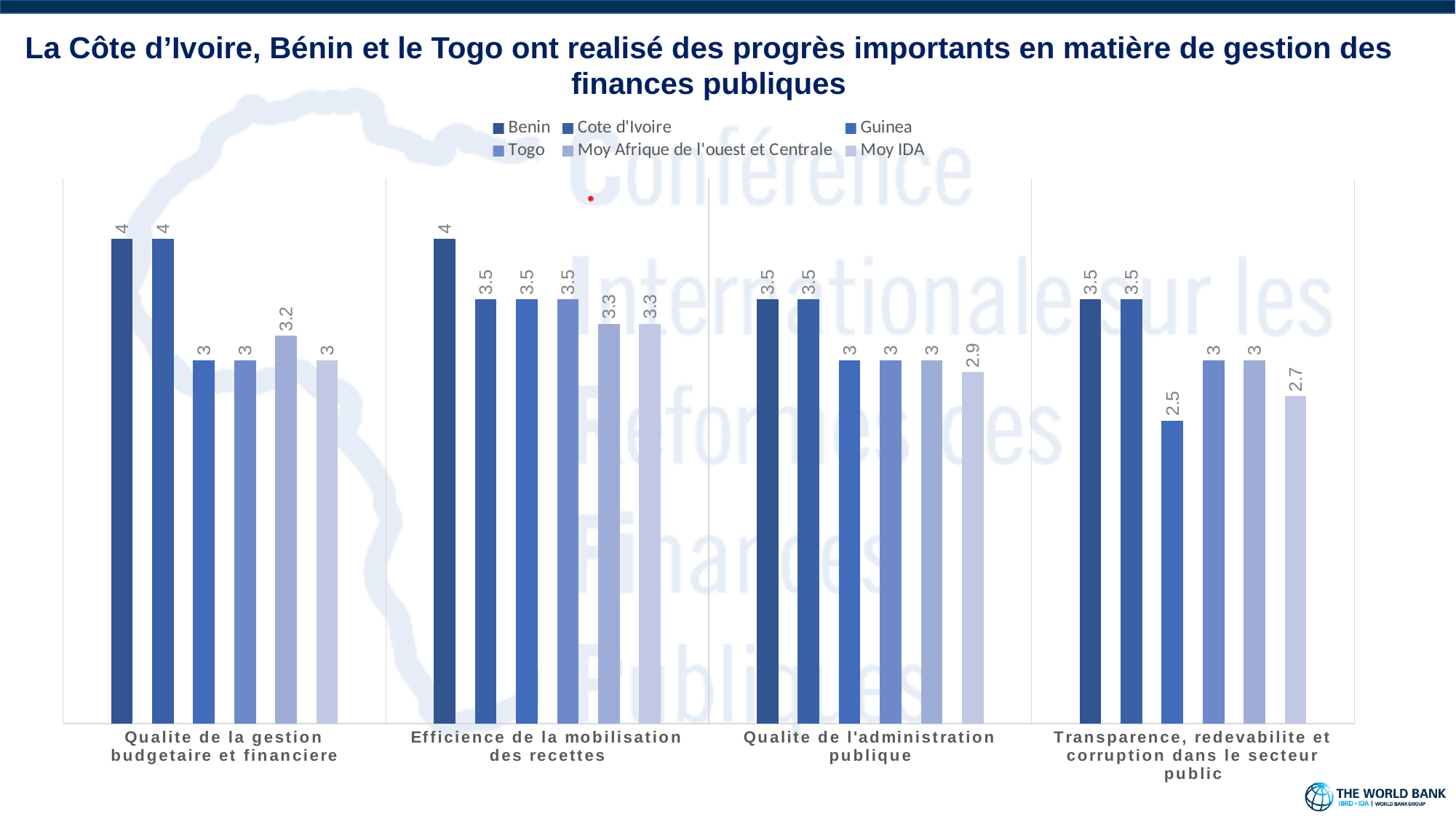
How many categories are shown on the x axis? 4 Which series has the lowest value in the category 'Qualite de l'administration publique'? Moy IDA What is the difference between Benin and Guinea in the category 'Transparence, redevabilite et corruption dans le secteur public'? 1 How many series does the legend list? 6 What is the value for Moy Afrique de l'ouest et Centrale in the category 'Qualite de la gestion budgetaire et financiere'? 3.2 What is the value for Moy IDA in the category 'Qualite de l'administration publique'? 2.9 Which series has the highest value in the category 'Efficience de la mobilisation des recettes'? Benin What is the value for Guinea in the category 'Transparence, redevabilite et corruption dans le secteur public'? 2.5 What is the value for Benin in the category 'Efficience de la mobilisation des recettes'? 4 What is the value for Moy IDA in the category 'Transparence, redevabilite et corruption dans le secteur public'? 2.7 In the category 'Qualite de la gestion budgetaire et financiere', which is larger: the value for Cote d'Ivoire or the value for Togo? Cote d'Ivoire What kind of chart is shown on the slide? bar chart